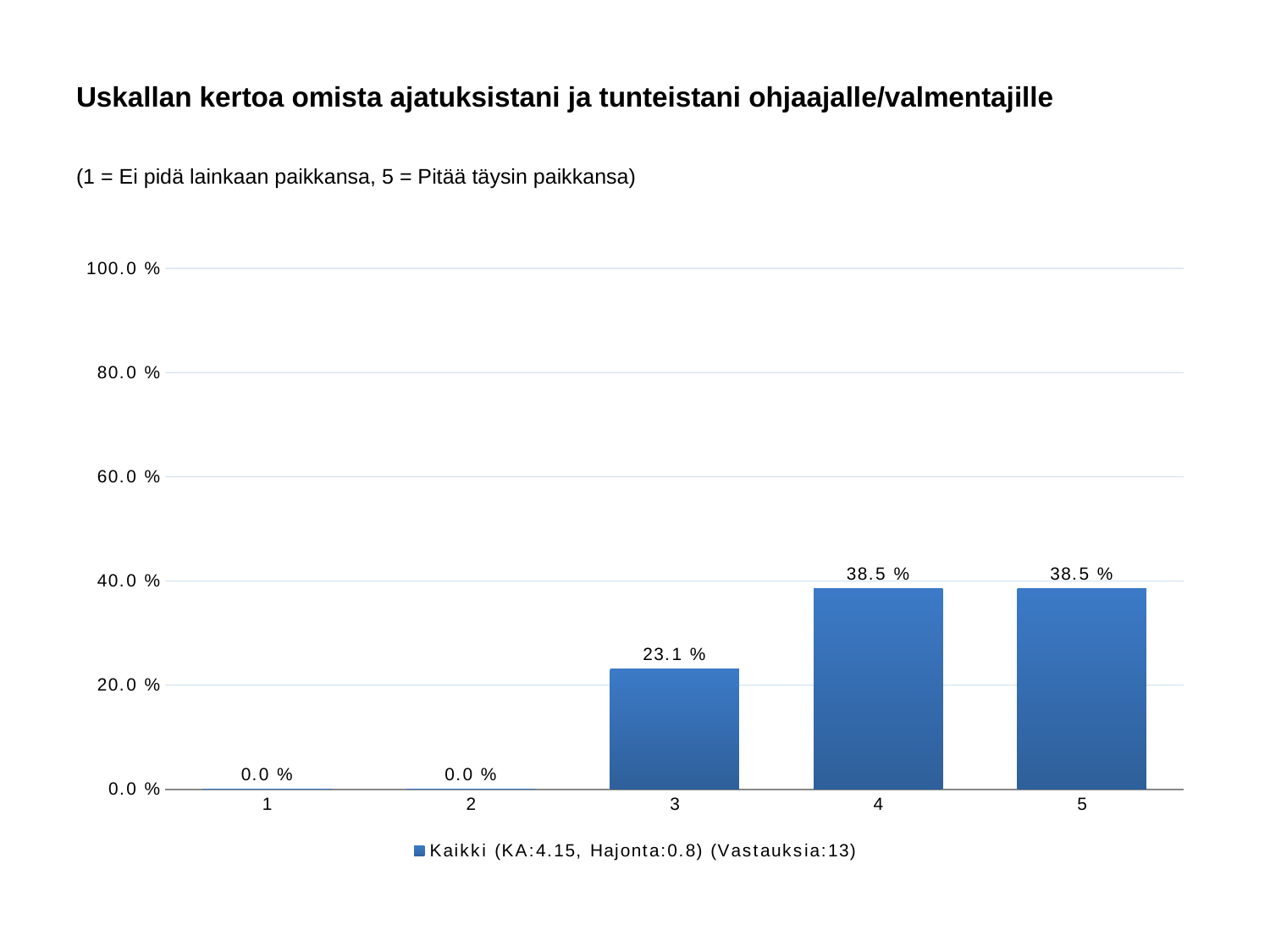
Is the value for category 3 greater or less than 20.0 %? greater How many series does the legend list? 1 Which category has the lowest value, 2 or 3? 2 Is the value for category 5 greater or less than 40.0 %? less What is the value for category 3? 23.1 % What is the legend entry for the series? Kaikki (KA:4.15, Hajonta:0.8) (Vastauksia:13) What is the difference between the values for category 4 and category 3? 15.4 % What kind of chart is shown? bar chart Which is larger, the value for category 3 or the value for category 5? 5 What is the value for category 1? 0.0 % How many categories are shown on the x axis? 5 What is the value for category 4? 38.5 %